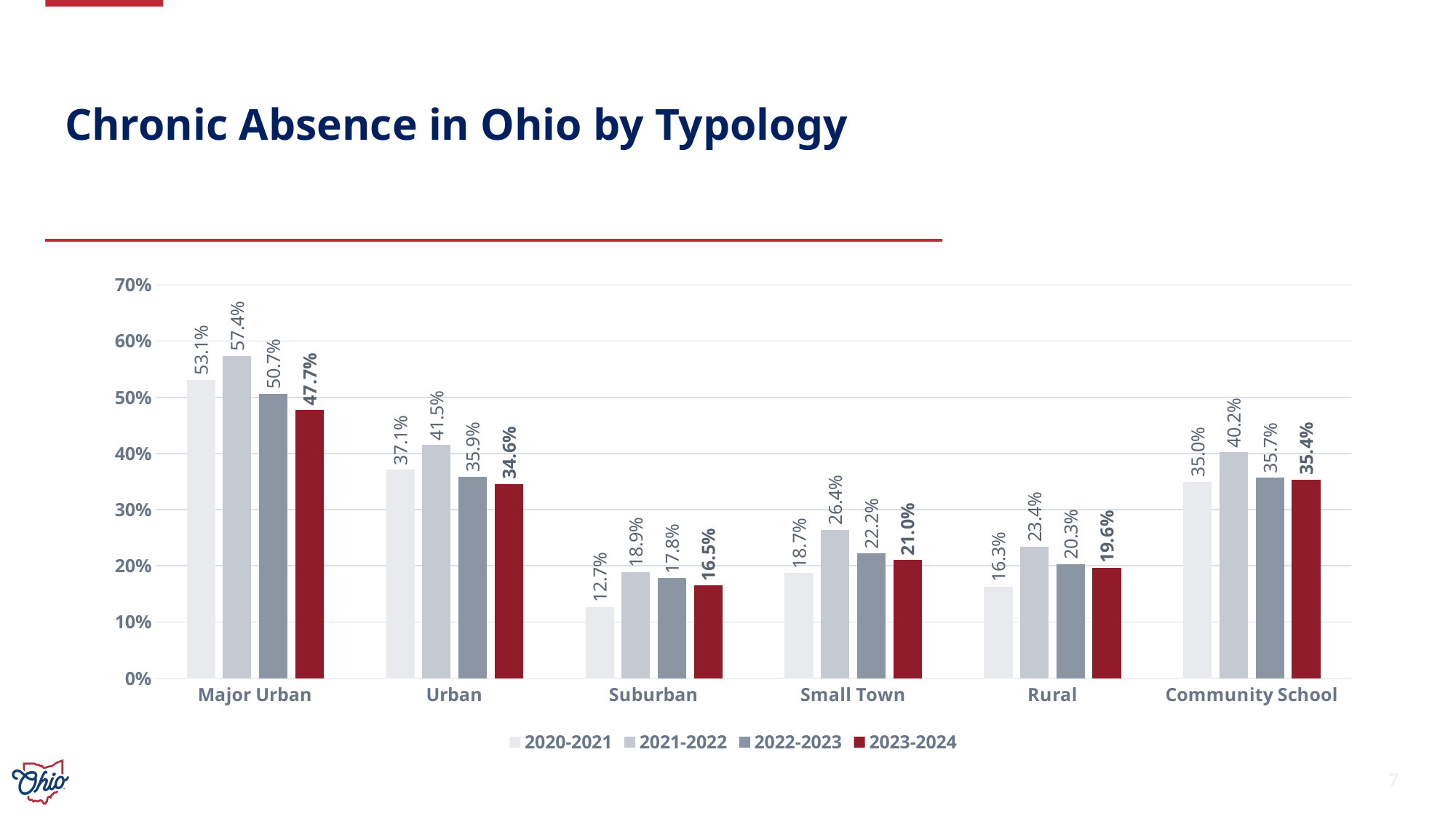
Which is larger, the Rural rate in 2021-2022 or the Small Town rate in 2021-2022? Small Town rate in 2021-2022 What is the title of the chart? Chronic Absence in Ohio by Typology Which typology has the lowest chronic absence rate in 2023-2024? Suburban What is the chronic absence rate for Major Urban in 2023-2024? 47.7% How many typology categories are shown on the x axis? 6 Which typology has the highest chronic absence rate in 2021-2022? Major Urban What is the chronic absence rate for Community School in 2021-2022? 40.2% What is the difference between the Major Urban rates for 2021-2022 and 2023-2024? 9.7% What is the chronic absence rate for Suburban in 2020-2021? 12.7% How many series does the legend list? 4 Is the Urban value for 2020-2021 greater or less than 30%? greater What kind of chart is shown on the slide? Bar chart